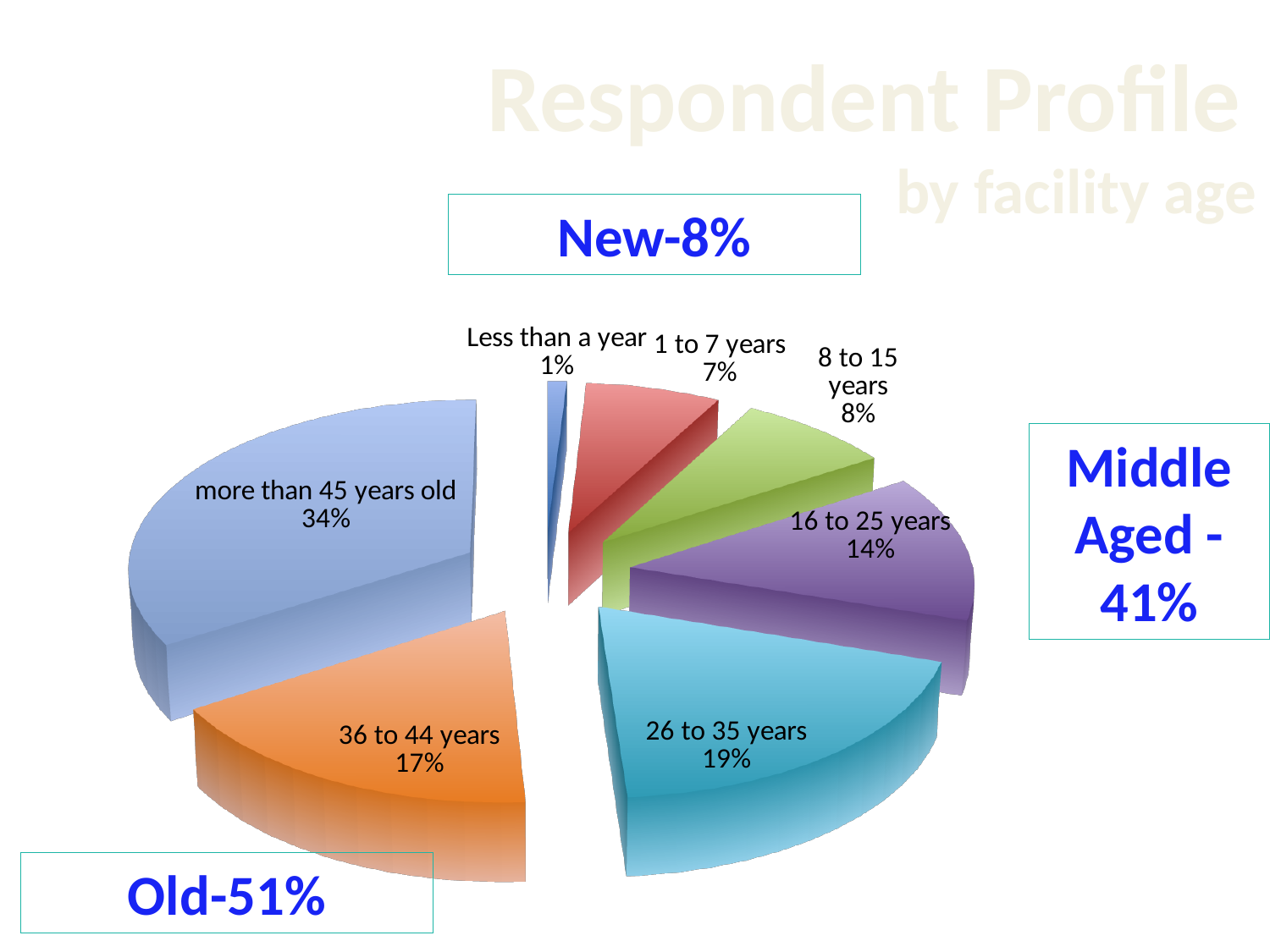
What share of respondents are from facilities aged 26 to 35 years? 19% What share of respondents are from facilities aged 8 to 15 years? 8% What is the combined share of the 36 to 44 years and more than 45 years old categories? 51% What percentage does the slide give for the 'Middle Aged' group? 41% What kind of chart is shown on the slide? pie chart What share of respondents are from facilities that are more than 45 years old? 34% Which has a larger share: 16 to 25 years or 1 to 7 years? 16 to 25 years How many facility age categories are shown in the pie chart? 7 What share of respondents are from facilities aged less than a year? 1% Which facility age category has the smallest share of respondents? Less than a year Which facility age category has the largest share of respondents? more than 45 years old What is the difference in share between the 26 to 35 years and 36 to 44 years categories? 2%